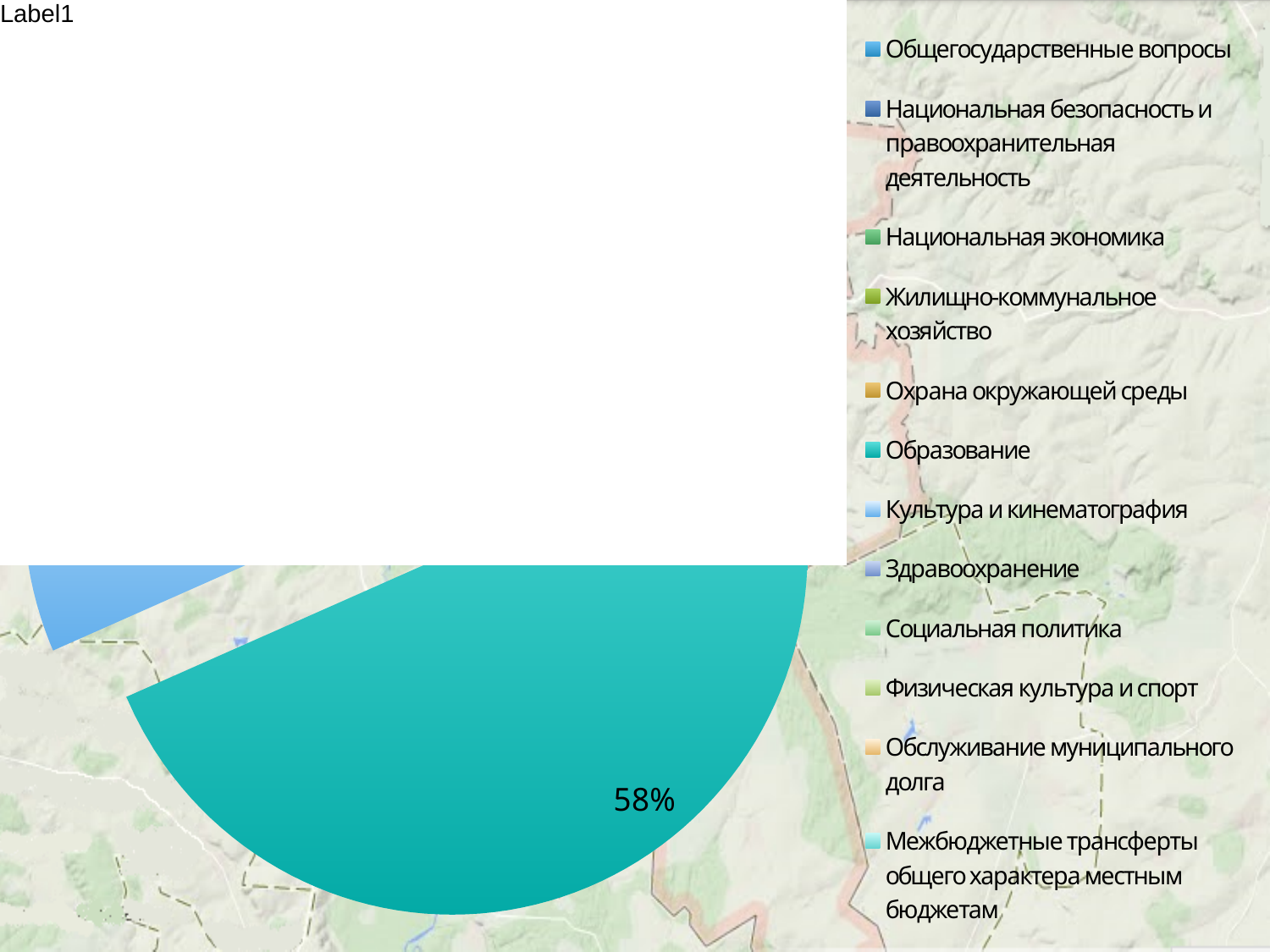
What is the last entry listed in the legend? Межбюджетные трансферты общего характера местным бюджетам What percentage is printed on the large teal slice of the pie chart? 58% How many categories does the legend of the pie chart list? 12 What kind of chart is shown on the slide? pie chart Is the share for Образование greater or less than 50%? greater Which category has the largest slice in the pie chart? Образование What is the first entry listed in the legend? Общегосударственные вопросы Which category does the slice labelled 58% represent? Образование What share of the pie does Образование take? 58%